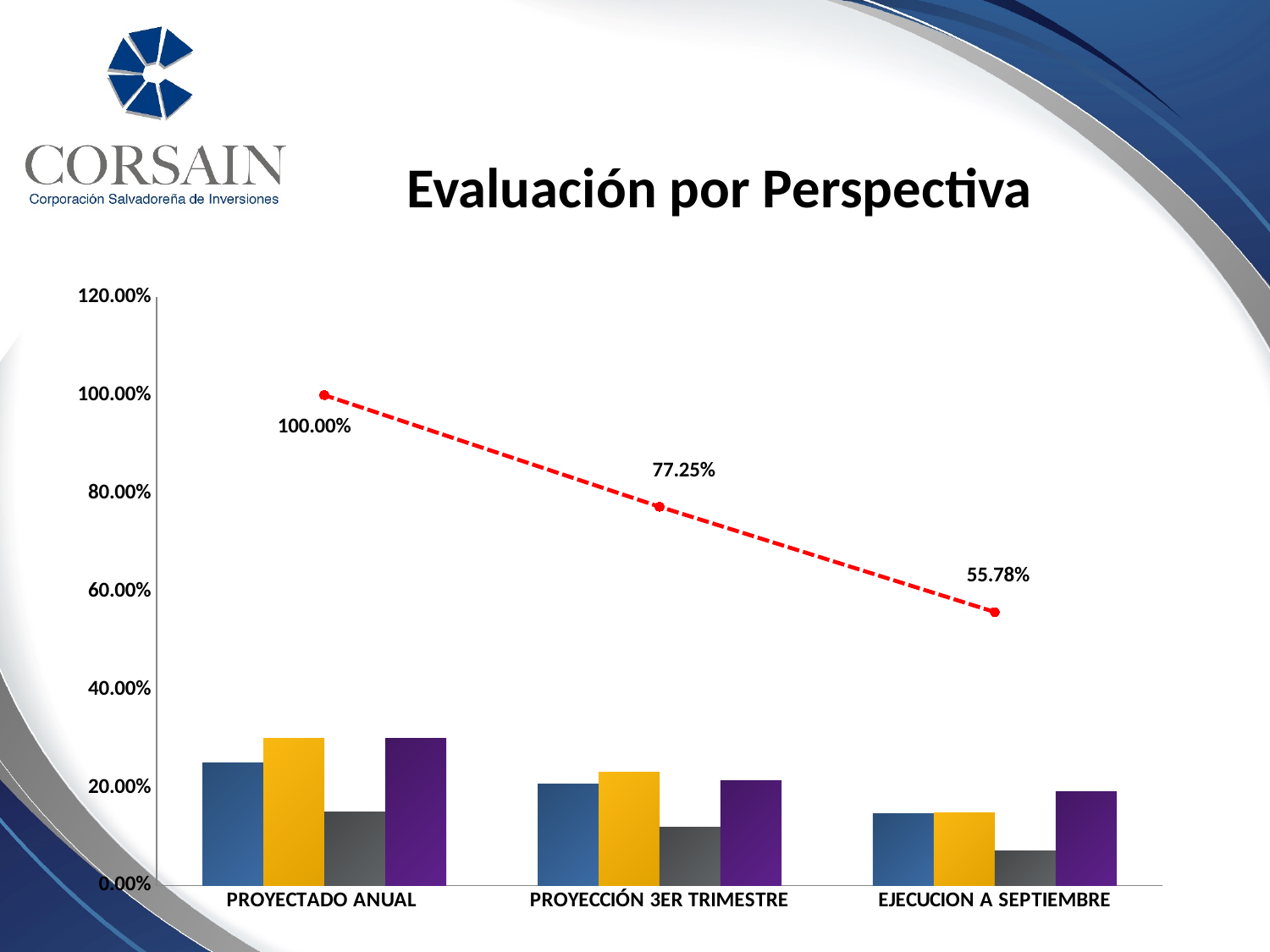
What value does the dashed line show for PROYECCIÓN 3ER TRIMESTRE? 77.25% Which category has the highest value on the dashed line? PROYECTADO ANUAL Which category has the lowest value on the dashed line? EJECUCION A SEPTIEMBRE What is the title of the chart? Evaluación por Perspectiva What is the difference between the line values for PROYECTADO ANUAL and EJECUCION A SEPTIEMBRE? 44.22% What value does the dashed line show for EJECUCION A SEPTIEMBRE? 55.78% How many categories are shown on the x axis? 3 What value does the dashed line show for PROYECTADO ANUAL? 100.00% What is the difference between the line values for PROYECCIÓN 3ER TRIMESTRE and EJECUCION A SEPTIEMBRE? 21.47% Is the value of the gray bar for PROYECTADO ANUAL greater or less than 20.00%? less Do the values of the dashed line rise or fall from left to right across the categories? fall Is the value of the yellow bar for PROYECTADO ANUAL greater or less than 20.00%? greater